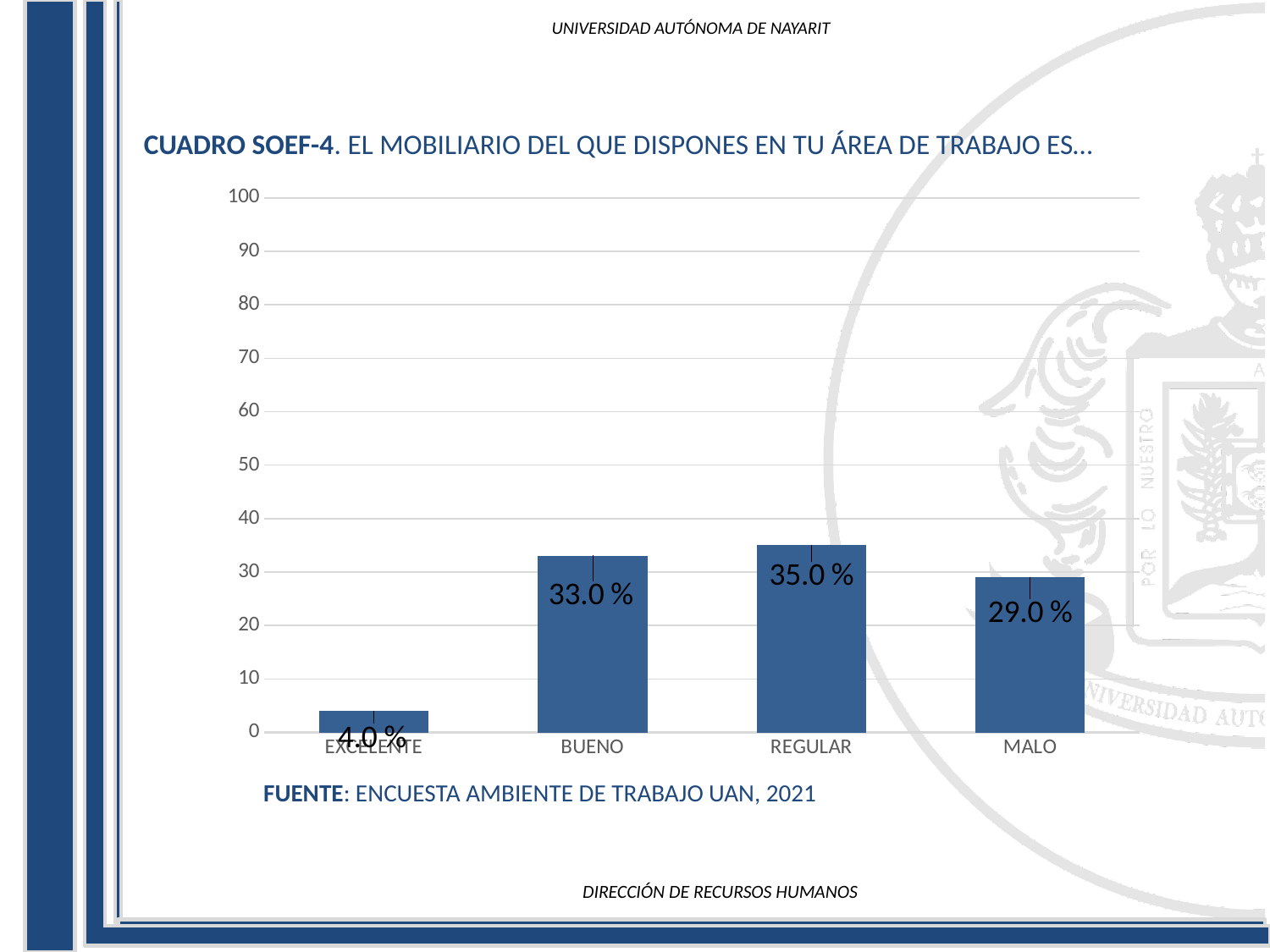
Which category has the highest value? REGULAR What kind of chart is shown on the slide? bar chart Which category has the lowest value? EXCELENTE Which is larger, the value for BUENO or the value for MALO? BUENO What is the value for EXCELENTE? 4.0 % What is the value for REGULAR? 35.0 % What is the value for MALO? 29.0 % What is the difference between the values for REGULAR and MALO? 6.0 % What is the value for BUENO? 33.0 % How many categories are shown on the x axis? 4 What is the source cited below the chart? ENCUESTA AMBIENTE DE TRABAJO UAN, 2021 Is the value for MALO greater or less than 20? greater